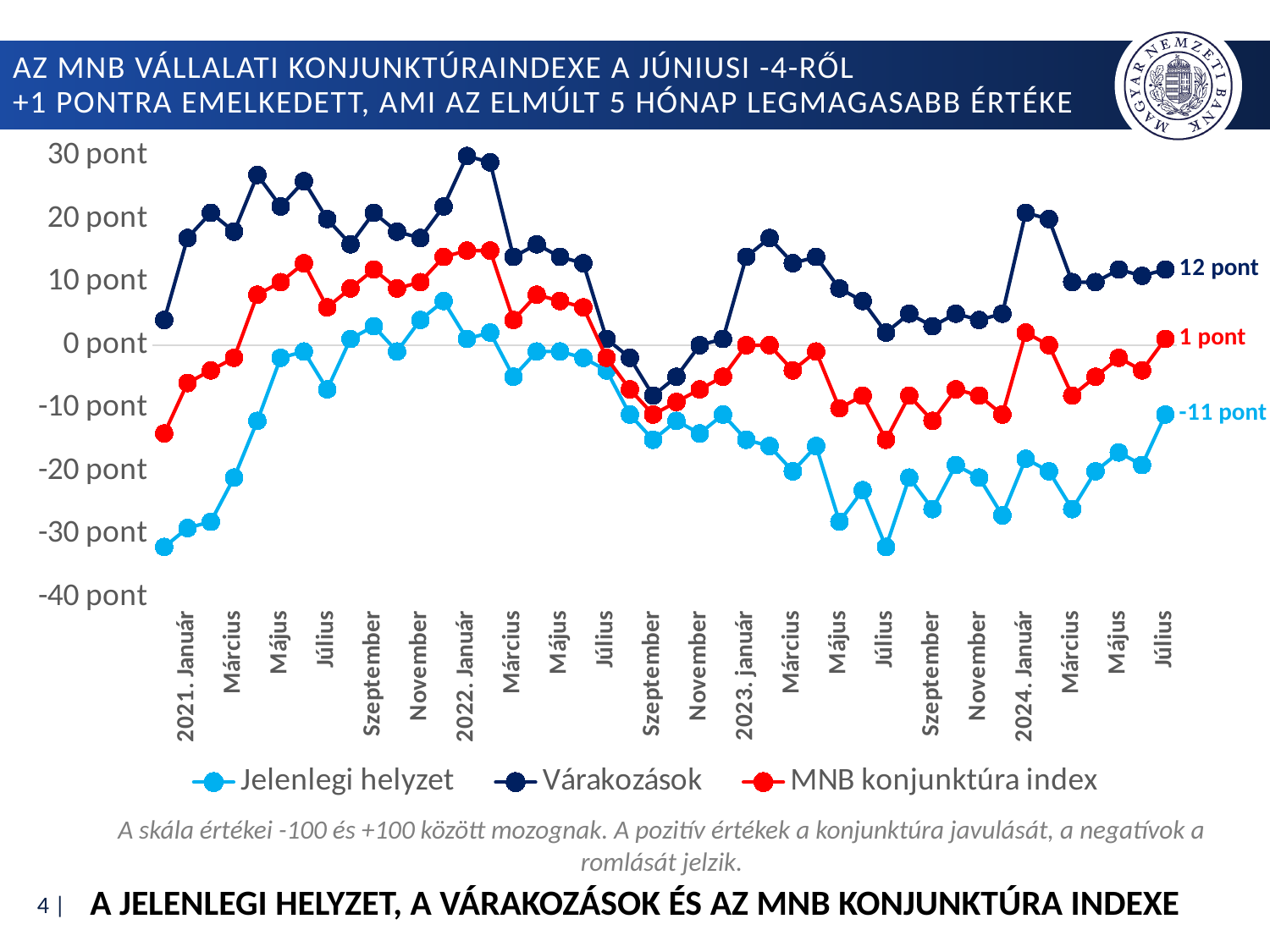
What is the value of the Jelenlegi helyzet series at the last point (2024. július)? -11 pont What is the value of the Várakozások series at the last point (2024. július)? 12 pont Is the value of the Jelenlegi helyzet series in 2021. január greater or less than -20 pont? less At the last point, which series is higher: Várakozások or Jelenlegi helyzet? Várakozások What is the value of the MNB konjunktúra index at the last point (2024. július)? 1 pont What is the difference between the Várakozások value (12 pont) and the Jelenlegi helyzet value (-11 pont) at the last point? 23 pont What kind of chart is shown on the slide? line chart Which series is drawn in red? MNB konjunktúra index What is the difference between the Várakozások value and the MNB konjunktúra index value at the last point? 11 pont Does the Várakozások series rise or fall between 2022. január and 2022. szeptember? fall Is the value of the Várakozások series in 2022. január greater or less than 20 pont? greater How many series does the legend list? 3